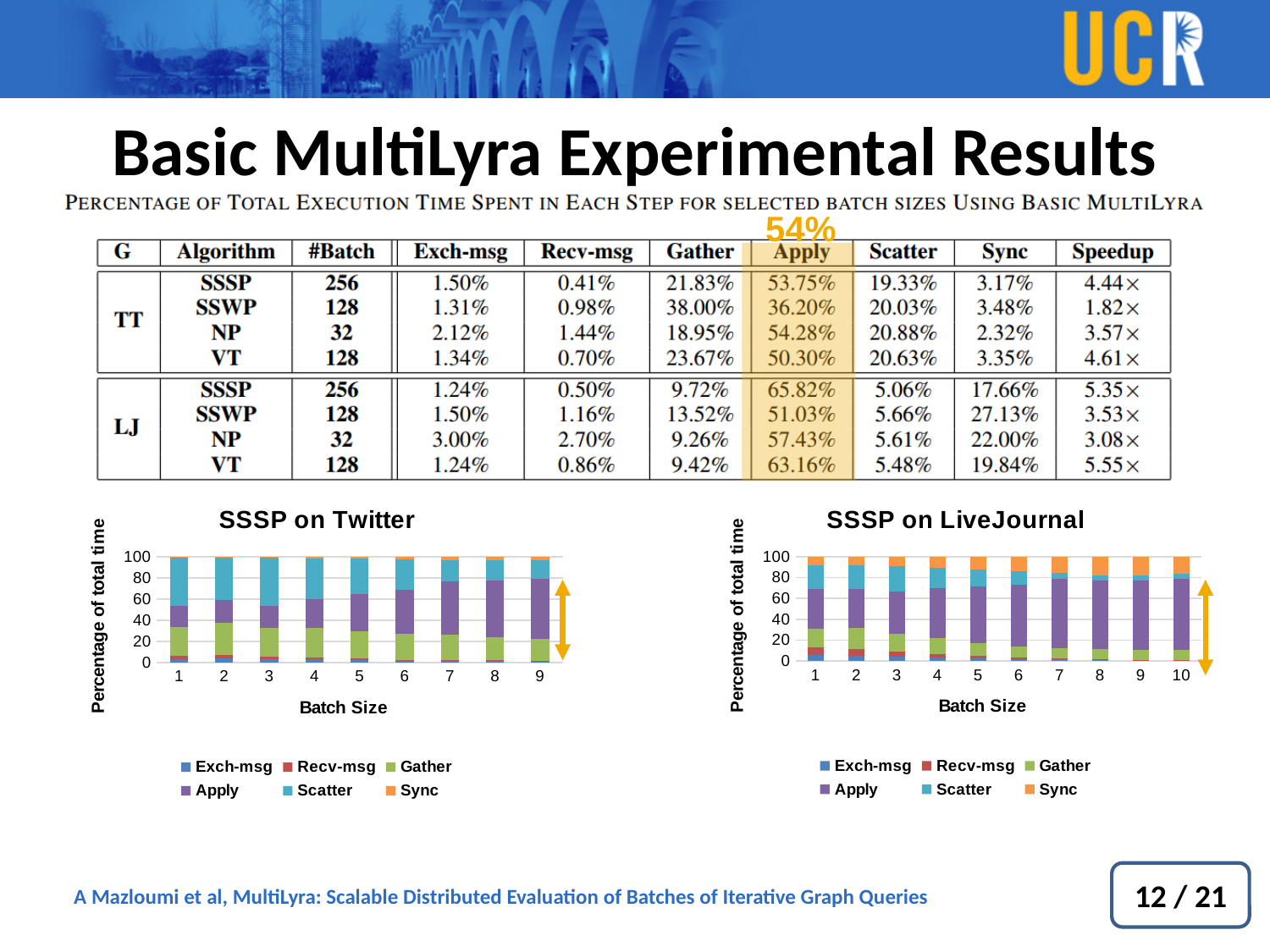
In the 'SSSP on Twitter' chart, what is the label of the y axis? Percentage of total time In the 'SSSP on LiveJournal' chart, which series is shown in orange? Sync How many batch sizes are plotted on the x axis of the 'SSSP on Twitter' chart? 9 In the 'SSSP on LiveJournal' chart, does the Gather segment grow or shrink as batch size increases along the x axis? Shrinks In the 'SSSP on Twitter' chart, does the Apply segment grow or shrink as batch size increases along the x axis? Grows How many batch sizes are plotted on the x axis of the 'SSSP on LiveJournal' chart? 10 How many series does the legend of the 'SSSP on LiveJournal' chart list? 6 In the 'SSSP on Twitter' chart, is the Scatter segment larger for batch size 1 or batch size 9? Batch size 1 In the 'SSSP on LiveJournal' chart, is the Apply segment for batch size 10 greater or less than 40? greater In the 'SSSP on LiveJournal' chart, what is the total height of each stacked bar? 100 In the 'SSSP on Twitter' chart, is the Apply segment for batch size 9 greater or less than 40? greater What kind of chart is 'SSSP on Twitter'? Stacked bar chart